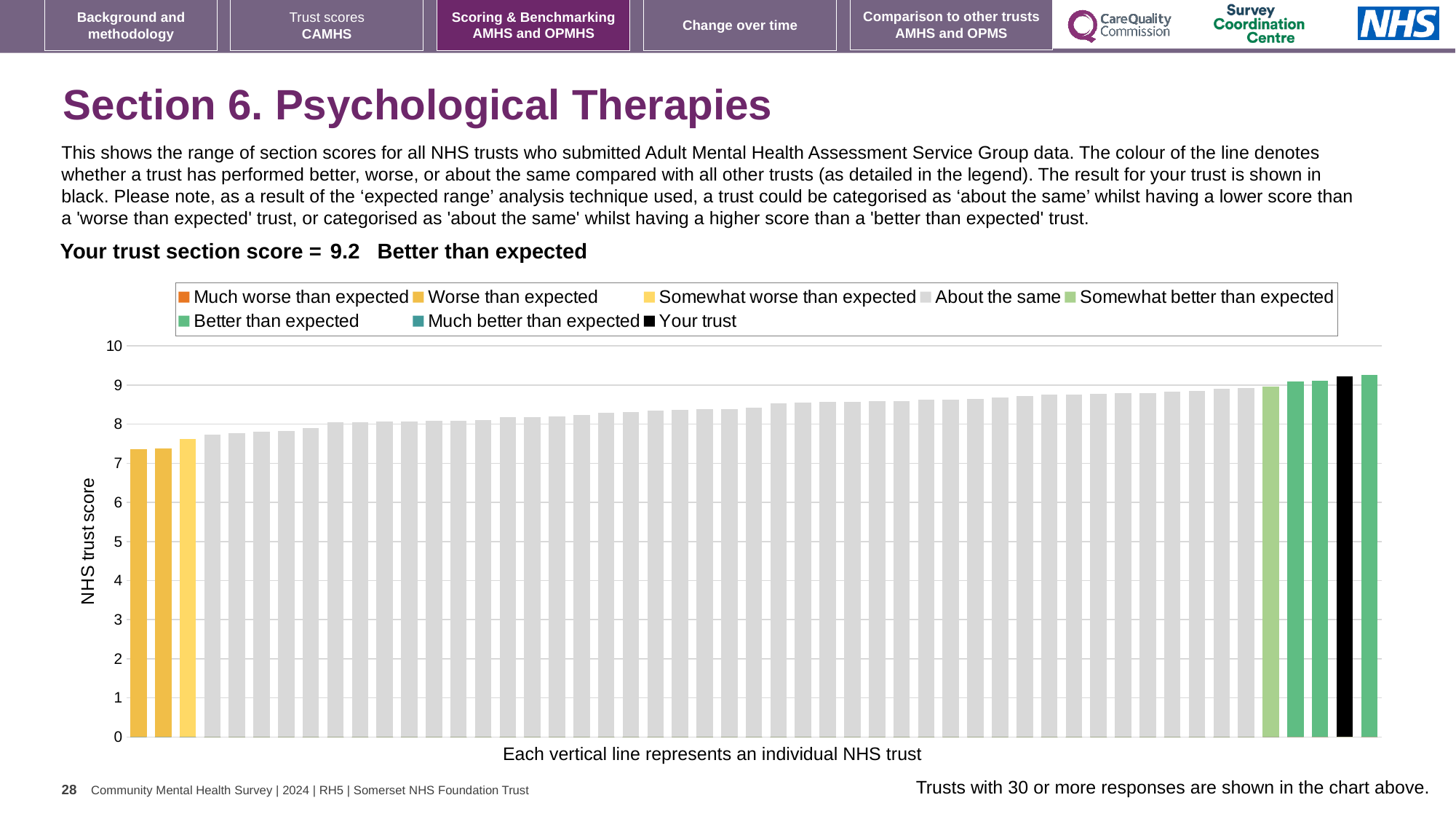
Is the value of the leftmost bar greater or less than 8? less Which performance category is your trust's section score given as? Better than expected Is the value of the rightmost bar greater or less than 9? greater Which is larger, the leftmost bar or the rightmost bar? The rightmost bar What is the section score for your trust shown on the slide? 9.2 Is the value for your trust (the black bar) greater or less than 9? greater What is the label on the vertical axis of the chart? NHS trust score What kind of chart is shown on the slide? Bar chart How many entries does the chart legend list? 8 How many bars are coloured as 'Worse than expected'? 2 Do the bar values rise or fall from left to right along the x axis? Rise What colour is the bar representing your trust? Black